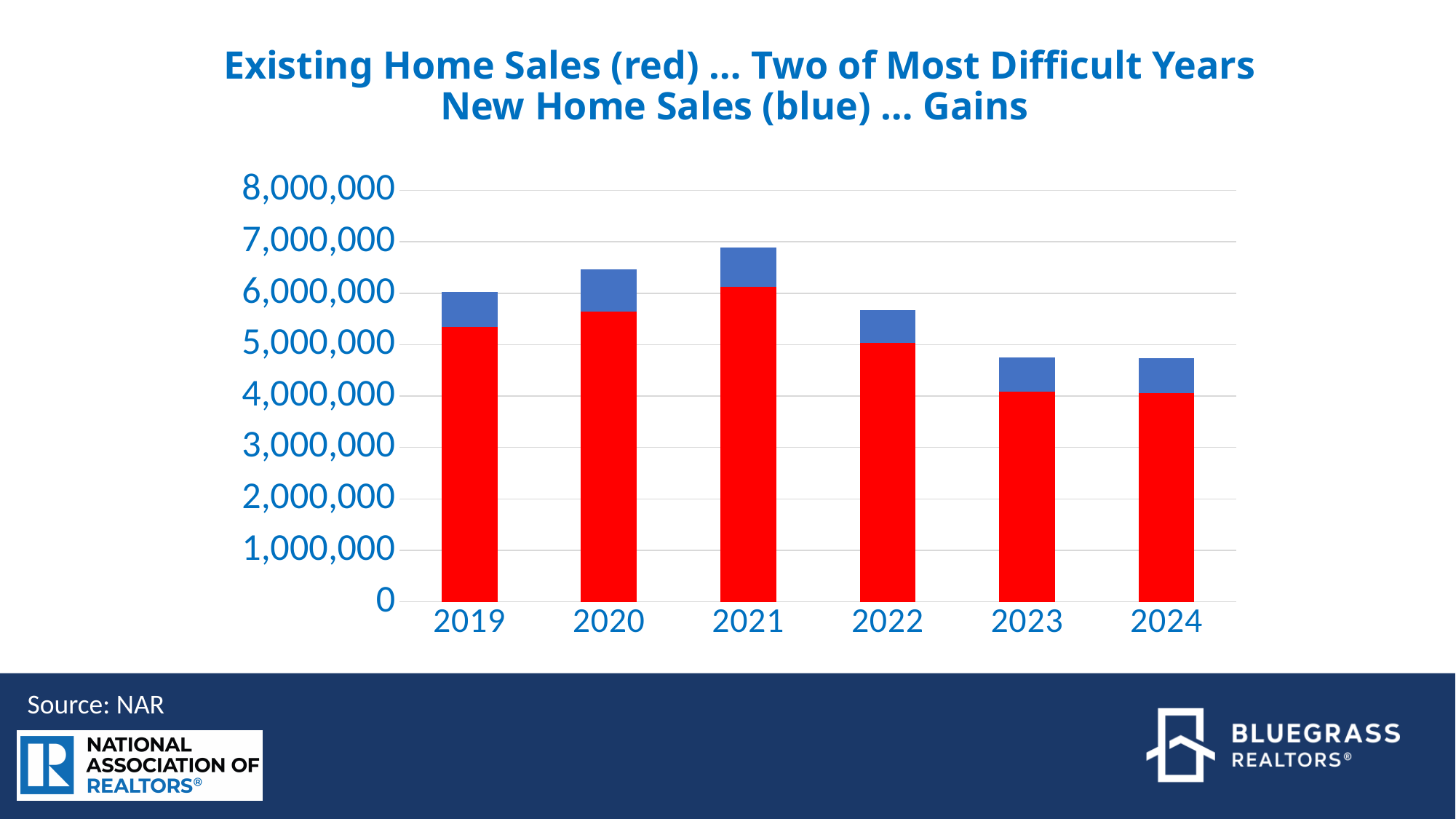
What is the source cited for the chart? NAR Which year has the tallest stacked bar in the chart? 2021 Is the total stacked bar for 2019 greater or less than 7,000,000? less Is the total stacked bar for 2022 greater or less than 5,000,000? greater Is the existing home sales (red) value for 2023 greater or less than 5,000,000? less Do the total stacked bars rise or fall from 2021 to 2024? fall Which colour represents new home sales in the chart? Blue How many years are shown on the x axis of the chart? 6 What kind of chart is shown on the slide? Stacked bar chart Which year has the larger existing home sales (red) value, 2020 or 2022? 2020